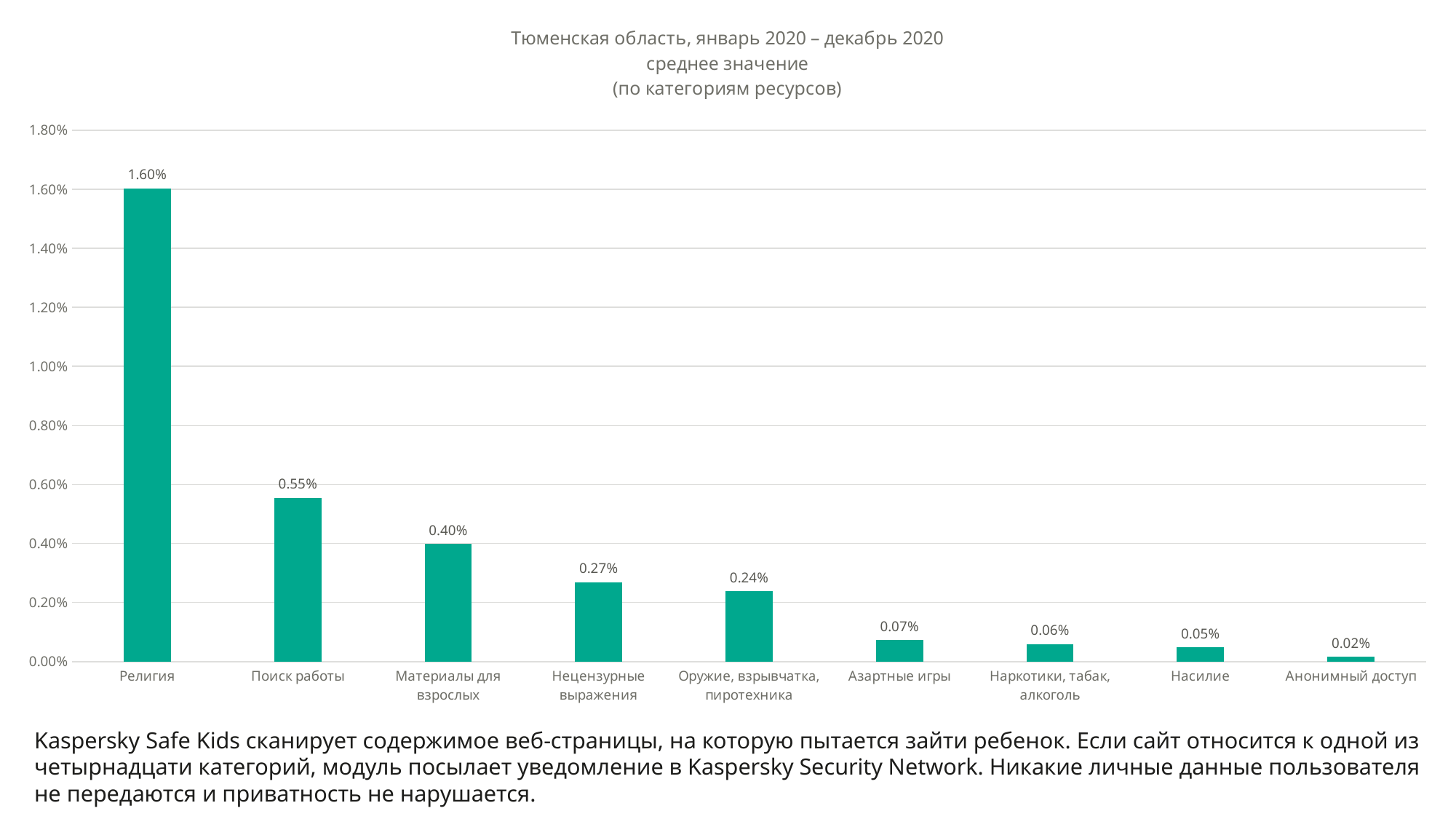
What is the value for Религия? 1.60% What is the value for Азартные игры? 0.07% How many categories are shown on the x axis? 9 What kind of chart is shown on the slide? bar chart Which is larger, the value for Оружие, взрывчатка, пиротехника or the value for Насилие? Оружие, взрывчатка, пиротехника Is the value for Материалы для взрослых greater or less than 0.60%? less Do the values rise or fall from left to right along the x axis? fall Which category has the highest value? Религия Which category has the lowest value? Анонимный доступ What is the difference between the values for Материалы для взрослых and Нецензурные выражения? 0.13% What is the difference between the values for Религия and Поиск работы? 1.05% What is the value for Поиск работы? 0.55%